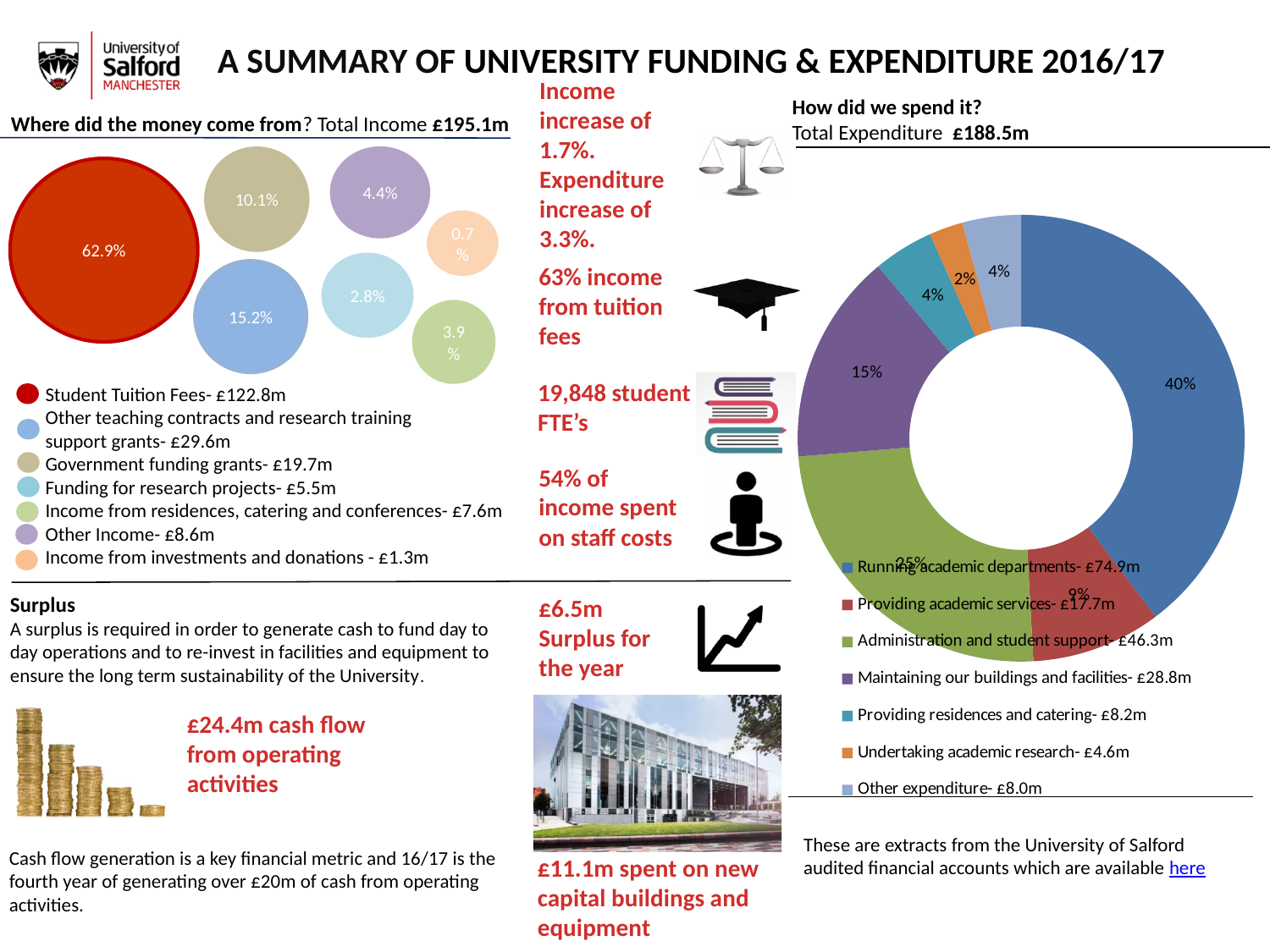
On the 'Where did the money come from?' chart, what is the value for Government funding grants? £19.7m On the 'How did we spend it?' doughnut chart, what is the expenditure for Running academic departments according to the legend? £74.9m On the 'How did we spend it?' doughnut chart, what is the expenditure for Maintaining our buildings and facilities? £28.8m On the 'How did we spend it?' doughnut chart, what percentage share is shown for the largest segment? 40% On the 'Where did the money come from?' bubble chart, what percentage is shown for the largest bubble? 62.9% On the 'How did we spend it?' doughnut chart, how many expenditure categories does the legend list? 7 On the 'How did we spend it?' doughnut chart, what is the difference between Administration and student support and Providing academic services? £28.6m On the 'Where did the money come from?' chart, which income source is the smallest? Income from investments and donations On the 'How did we spend it?' doughnut chart, which category has the smallest expenditure? Undertaking academic research On the 'How did we spend it?' chart, which is larger: Providing residences and catering or Other expenditure? Providing residences and catering On the 'How did we spend it?' doughnut chart, which category has the largest share? Running academic departments What kind of chart is used for 'How did we spend it?'? Doughnut chart